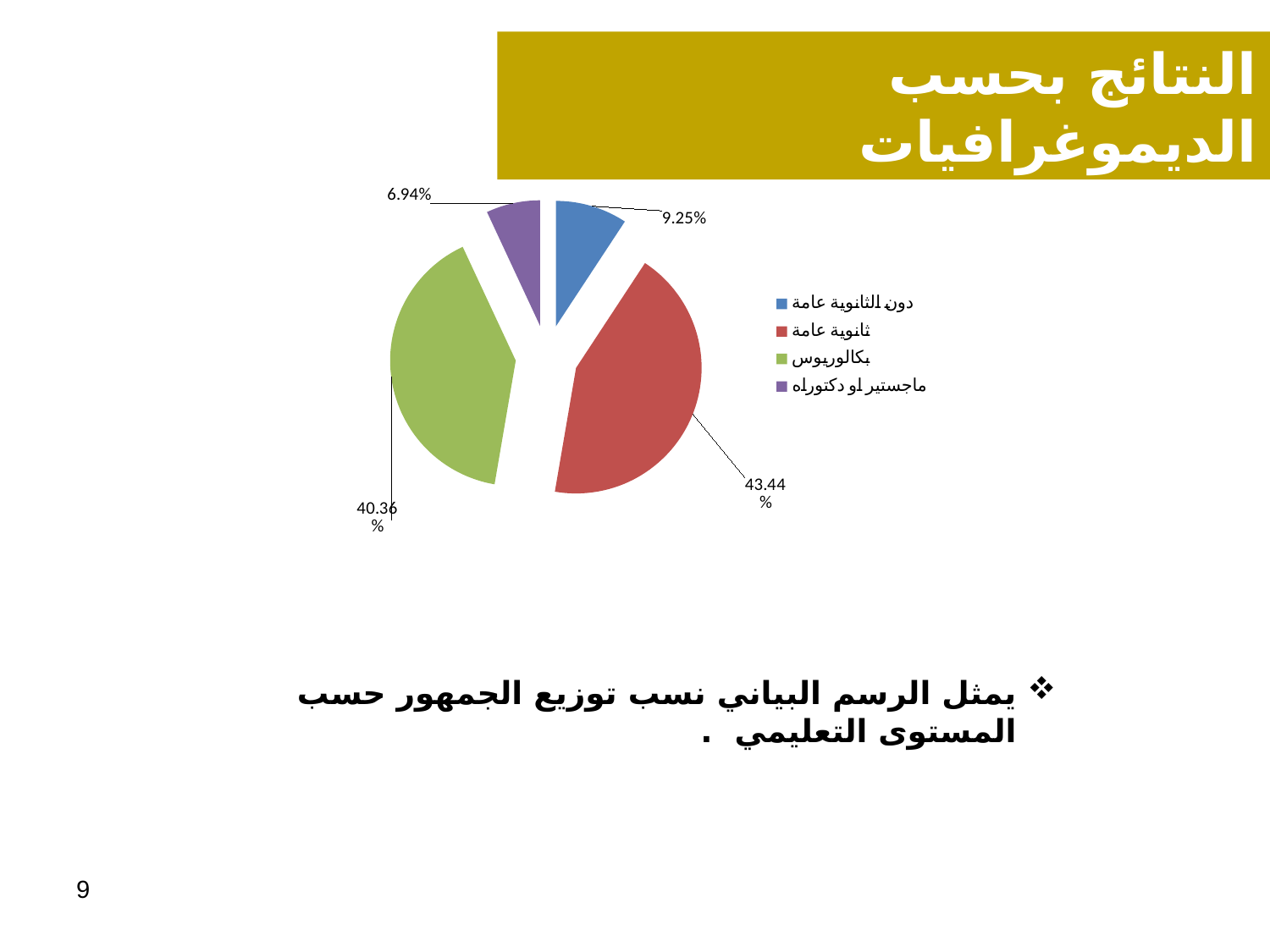
What percentage does the slice for ثانوية عامة represent? 43.44% What is the difference between the shares of دون الثانوية عامة and ماجستير او دكتوراه? 2.31% What kind of chart is shown on the slide? pie chart Which category has the largest share of the pie? ثانوية عامة Which category has the smallest share of the pie? ماجستير او دكتوراه How many categories does the legend list? 4 What is the difference between the shares of ثانوية عامة and بكالوريوس? 3.08% What percentage does the slice for بكالوريوس represent? 40.36% What percentage does the slice for دون الثانوية عامة represent? 9.25% Which is larger, the share for دون الثانوية عامة or the share for ماجستير او دكتوراه? دون الثانوية عامة What colour is the slice for بكالوريوس? green What percentage does the slice for ماجستير او دكتوراه represent? 6.94%